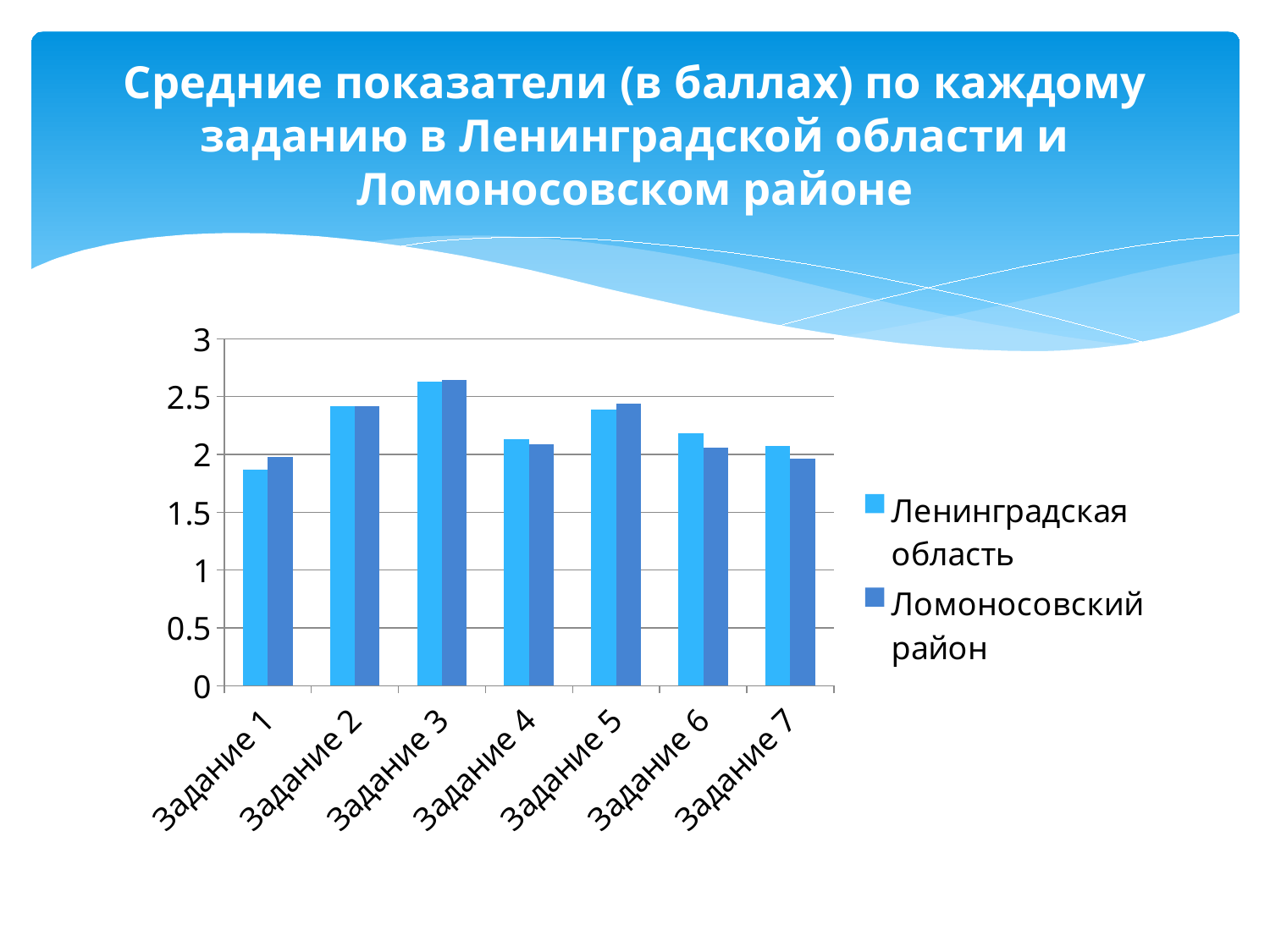
Which task has the highest value for Ленинградская область? Задание 3 Is the value for Ленинградская область on Задание 1 greater or less than 2? less For Задание 1, which series has the larger value: Ленинградская область or Ломоносовский район? Ломоносовский район For Задание 6, which series has the larger value: Ленинградская область or Ломоносовский район? Ленинградская область How many series does the legend list? 2 What are the two series listed in the legend? Ленинградская область and Ломоносовский район Which task has the lowest value for Ленинградская область? Задание 1 Is the value for Ломоносовский район on Задание 3 greater or less than 2.5? greater How many tasks (categories) are shown on the x axis? 7 What kind of chart is shown on the slide? Bar chart